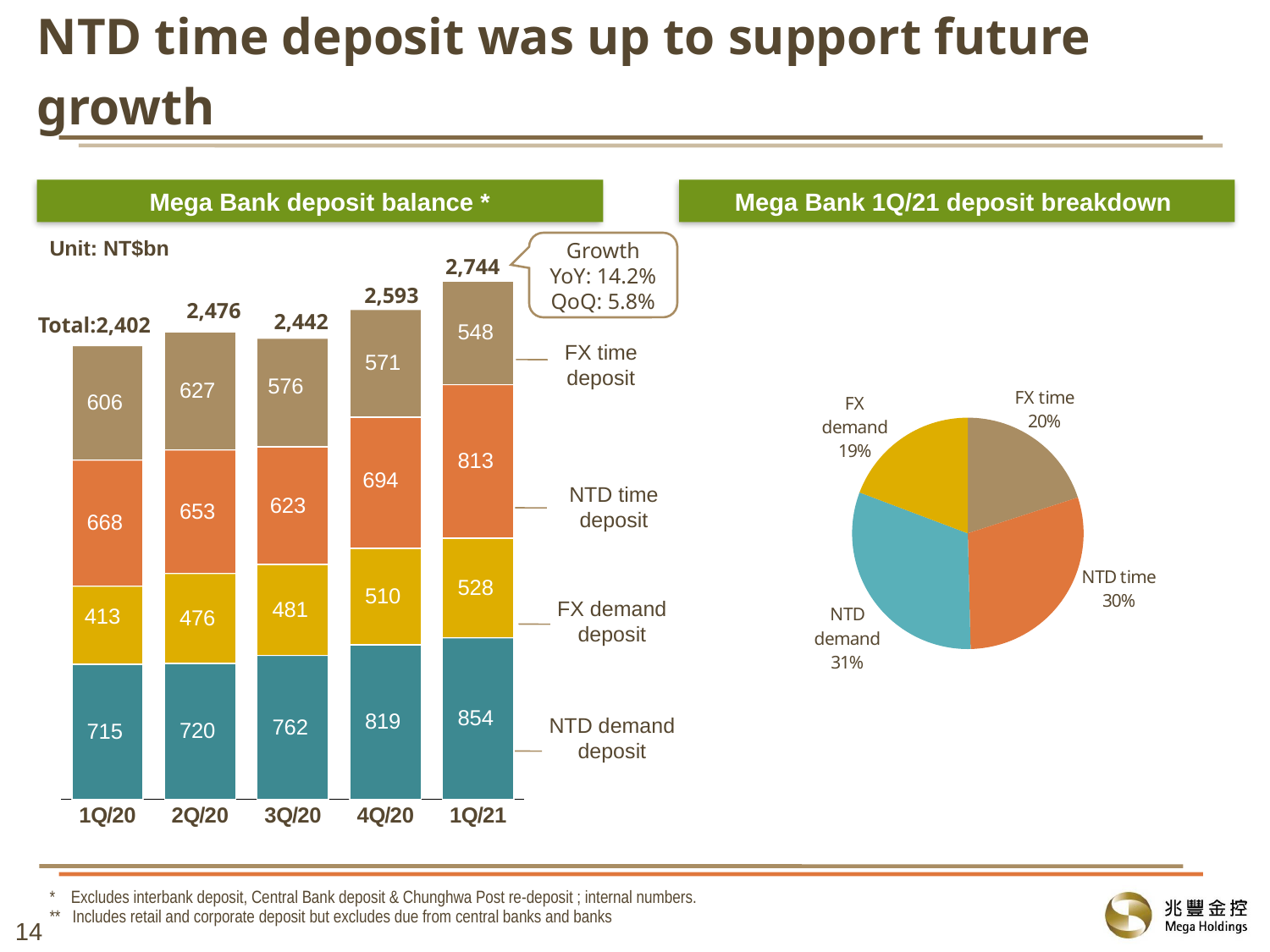
In the 'Mega Bank deposit balance' chart, does the NTD demand deposit rise or fall from 1Q/20 to 1Q/21? Rise In the 'Mega Bank deposit balance' chart, what is the NTD demand deposit value for 1Q/21? 854 What kind of chart is the 'Mega Bank deposit balance' chart? Stacked bar chart In the 'Mega Bank deposit balance' chart, which quarter has the lowest total deposit balance? 1Q/20 In the 'Mega Bank deposit balance' chart, what is the FX time deposit value for 4Q/20? 571 How many quarters are shown in the 'Mega Bank deposit balance' chart? 5 In the 'Mega Bank 1Q/21 deposit breakdown' pie chart, what share is NTD demand? 31% In the 'Mega Bank deposit balance' chart, what is the total deposit balance for 2Q/20? 2,476 In the 'Mega Bank 1Q/21 deposit breakdown' pie chart, which slice is the smallest? FX demand In the 'Mega Bank deposit balance' chart, what is the difference between the NTD time deposit values for 1Q/21 and 4Q/20? 119 In the 'Mega Bank deposit balance' chart, which is larger: the FX demand deposit for 3Q/20 or for 2Q/20? 3Q/20 In the 'Mega Bank deposit balance' chart, which quarter has the highest total deposit balance? 1Q/21